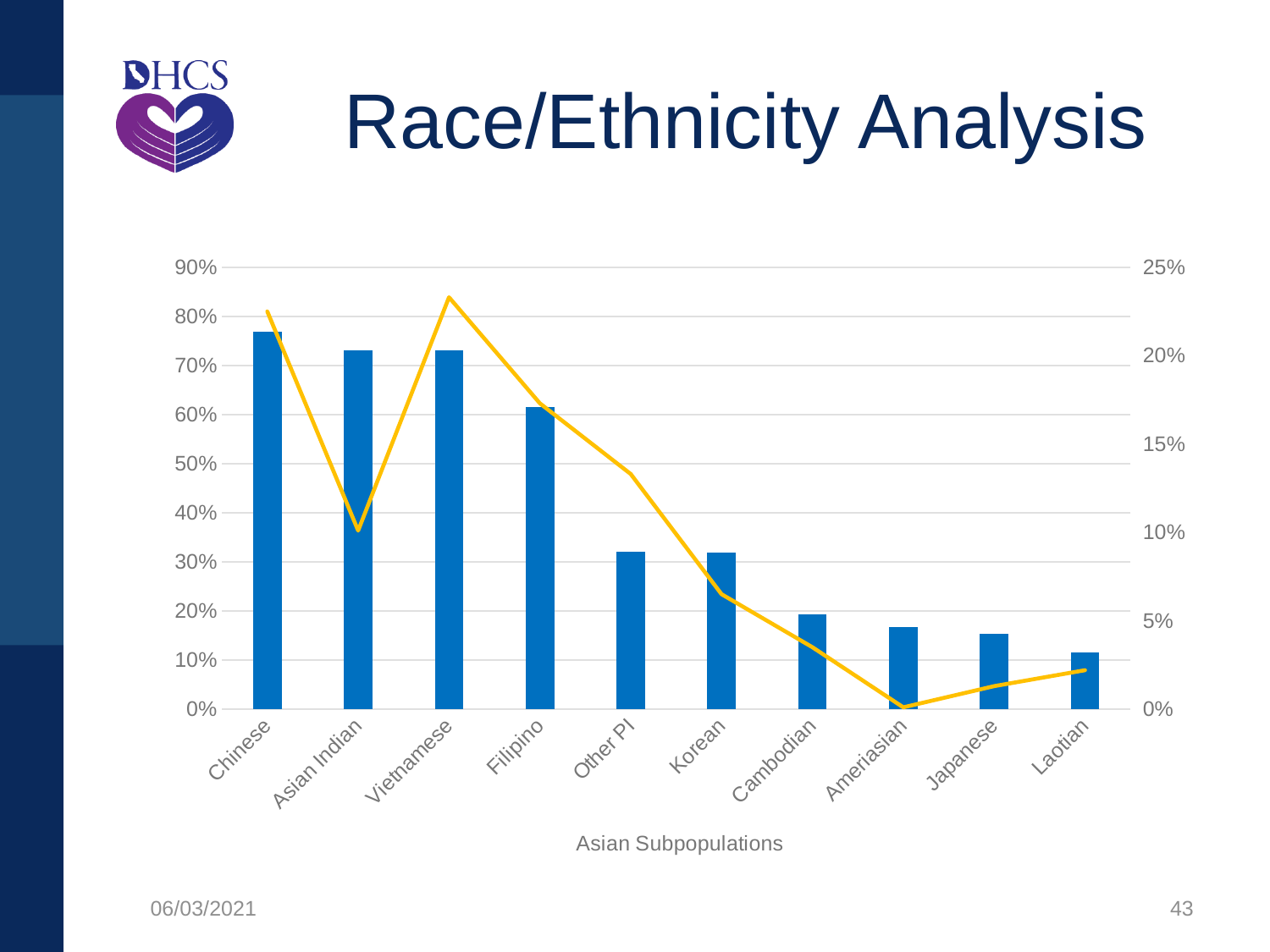
Which Asian subpopulation has the shortest bar in the chart? Laotian At which Asian subpopulation does the yellow line reach its lowest point? Ameriasian Which has the taller bar, Cambodian or Laotian? Cambodian Is the bar value for Laotian greater or less than 20%? less What is the title of the x axis of the chart? Asian Subpopulations Is the bar value for Other PI greater or less than 20%? greater Do the bar values generally rise or fall moving from left to right along the x axis? fall Which Asian subpopulation has the tallest bar in the chart? Chinese Is the bar value for Filipino greater or less than 70%? less How many Asian subpopulation categories are shown on the x axis of the chart? 10 Which has the taller bar, Filipino or Other PI? Filipino